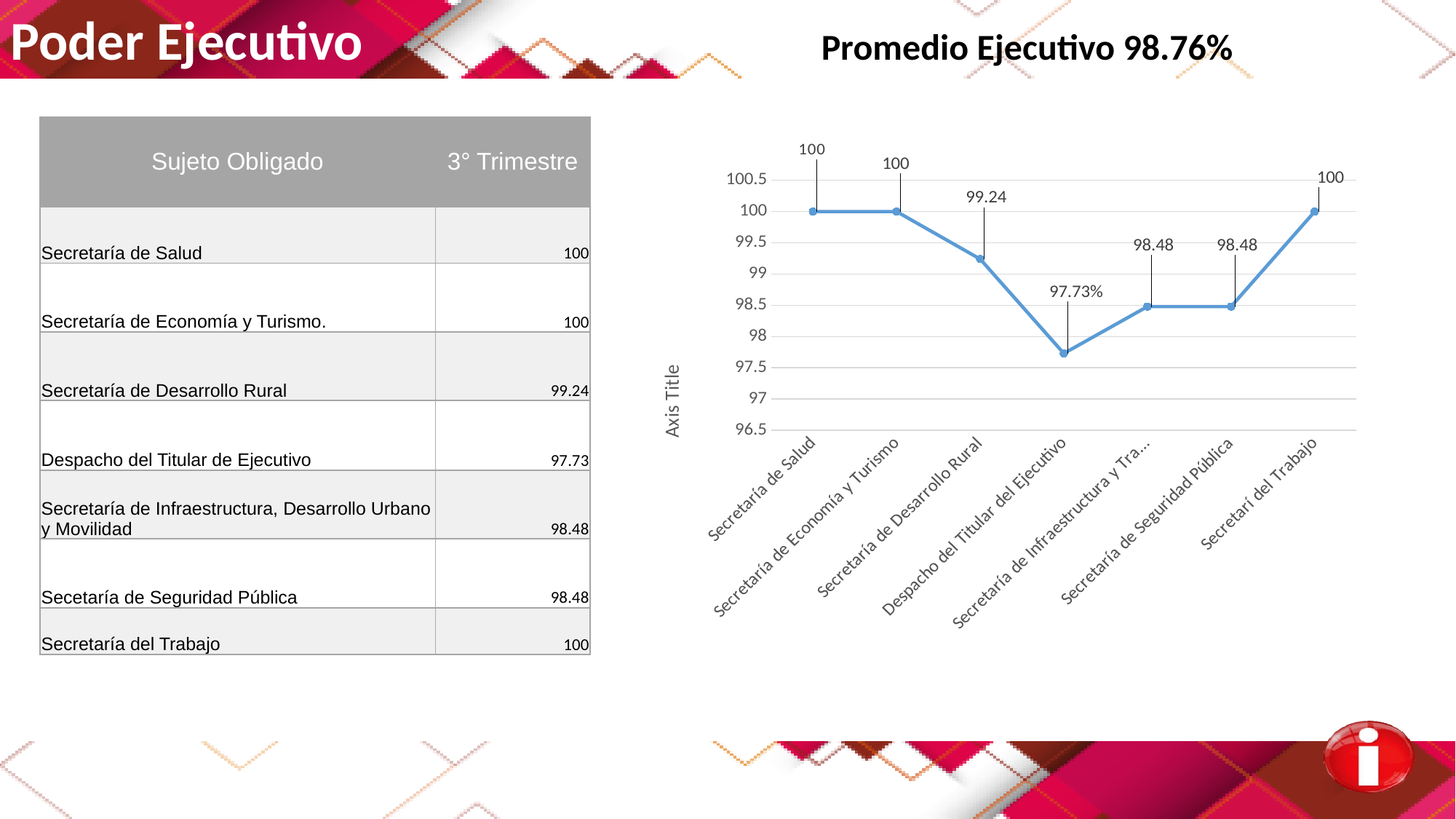
What kind of chart is shown on the slide? line chart What is the value plotted for Secretaría de Desarrollo Rural? 99.24 Do the values rise or fall from Secretaría de Economía y Turismo to Despacho del Titular del Ejecutivo? fall Is the value for Secretaría de Desarrollo Rural greater or less than 99? greater Which category has the lowest value on the chart? Despacho del Titular del Ejecutivo What is the value plotted for Secretaría de Salud? 100 How many categories are plotted on the chart? 7 What data label is shown for Despacho del Titular del Ejecutivo? 97.73% Which is larger, the value for Secretaría de Economía y Turismo or the value for Secretaría de Desarrollo Rural? Secretaría de Economía y Turismo What is the value plotted for Secretaría de Seguridad Pública? 98.48 What is the difference between the values for Secretaría de Desarrollo Rural and Secretaría de Seguridad Pública? 0.76 What is the title shown on the vertical axis of the chart? Axis Title